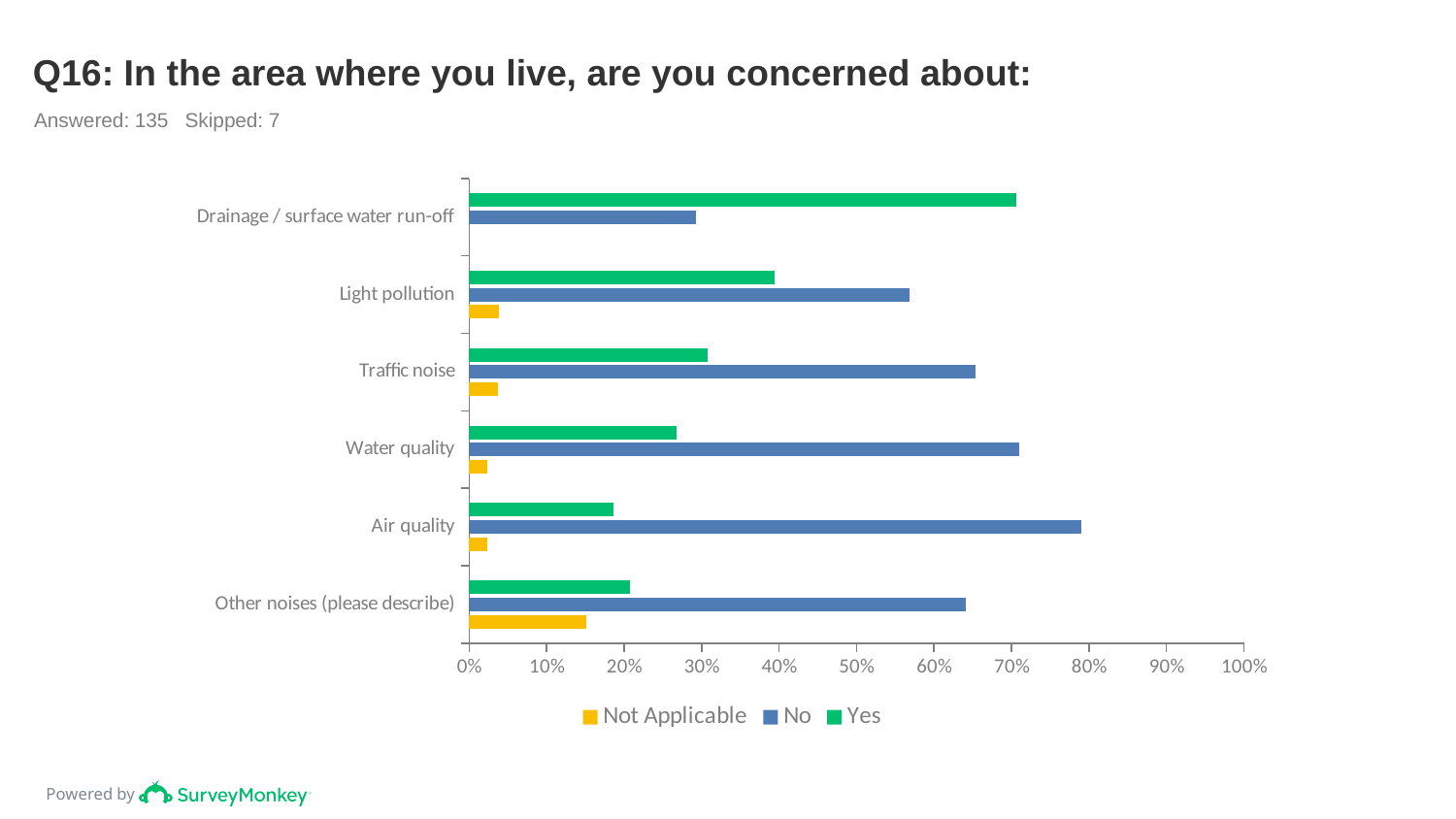
Is the 'Yes' value for Air quality greater or less than 30%? less Which category has the highest 'Yes' value? Drainage / surface water run-off Which category has the highest 'Not Applicable' value? Other noises (please describe) How many categories are plotted on the y axis? 6 Which category has the highest 'No' value? Air quality Is the 'Yes' value for Drainage / surface water run-off greater or less than 60%? greater Is the 'No' value for Air quality greater or less than 70%? greater Which colour represents the 'Yes' series in the legend? green What kind of chart is shown on the slide? bar chart For Light pollution, which is larger: the 'Yes' value or the 'No' value? No How many series does the legend list? 3